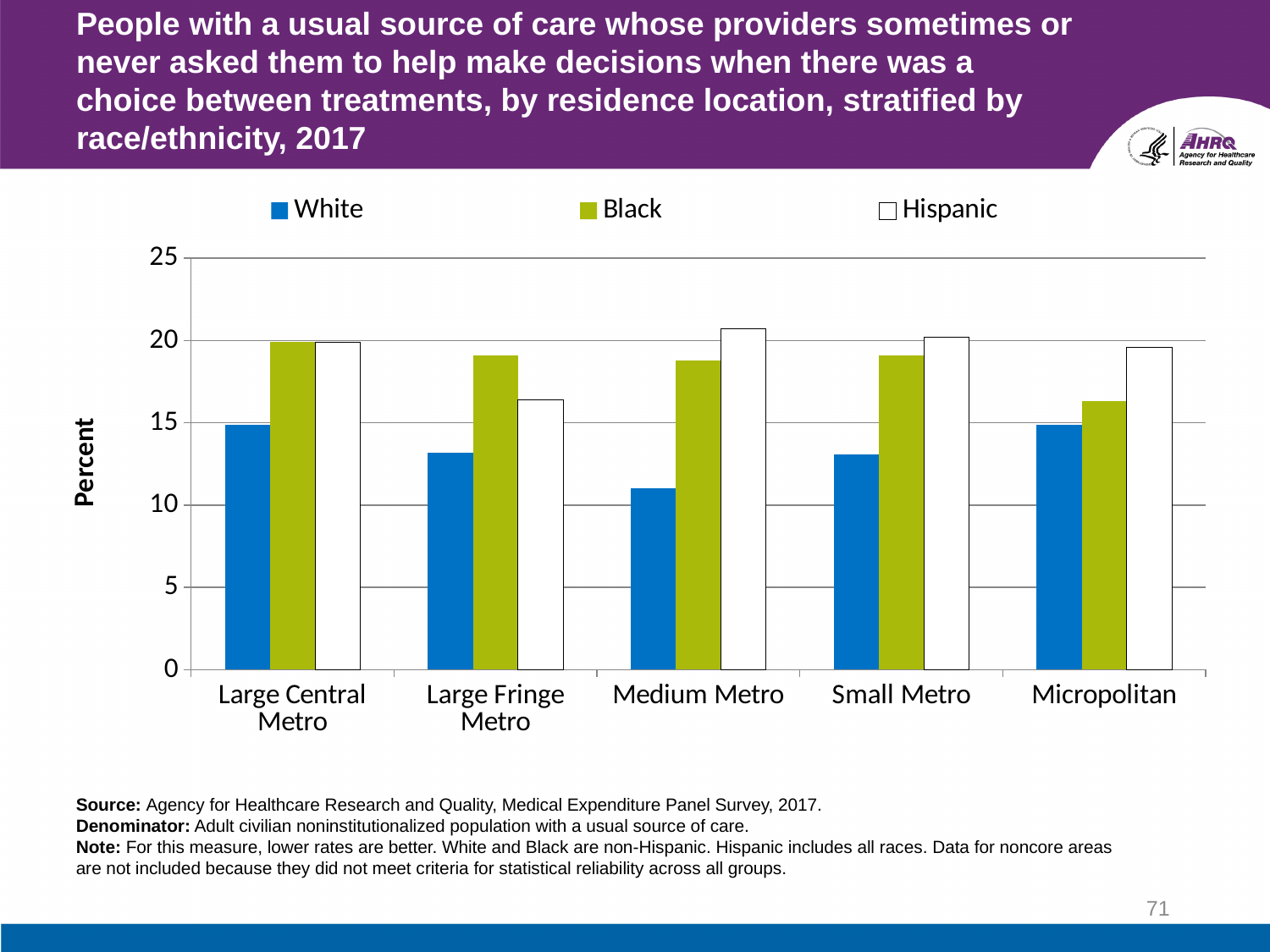
How many series does the legend list? 3 Is the value for Hispanic in Large Fringe Metro greater or less than 15? greater How many residence location categories are shown on the x axis? 5 Which residence location has the lowest value for White? Medium Metro What kind of chart is shown on the slide? bar chart In Medium Metro, which is larger, the value for White or the value for Hispanic? Hispanic Is the value for Black in Medium Metro greater or less than 15? greater Which colour represents the White series in the legend? blue In Micropolitan, which is larger, the value for Black or the value for Hispanic? Hispanic Is the value for White in Large Fringe Metro greater or less than 15? less What is the label on the y axis? Percent